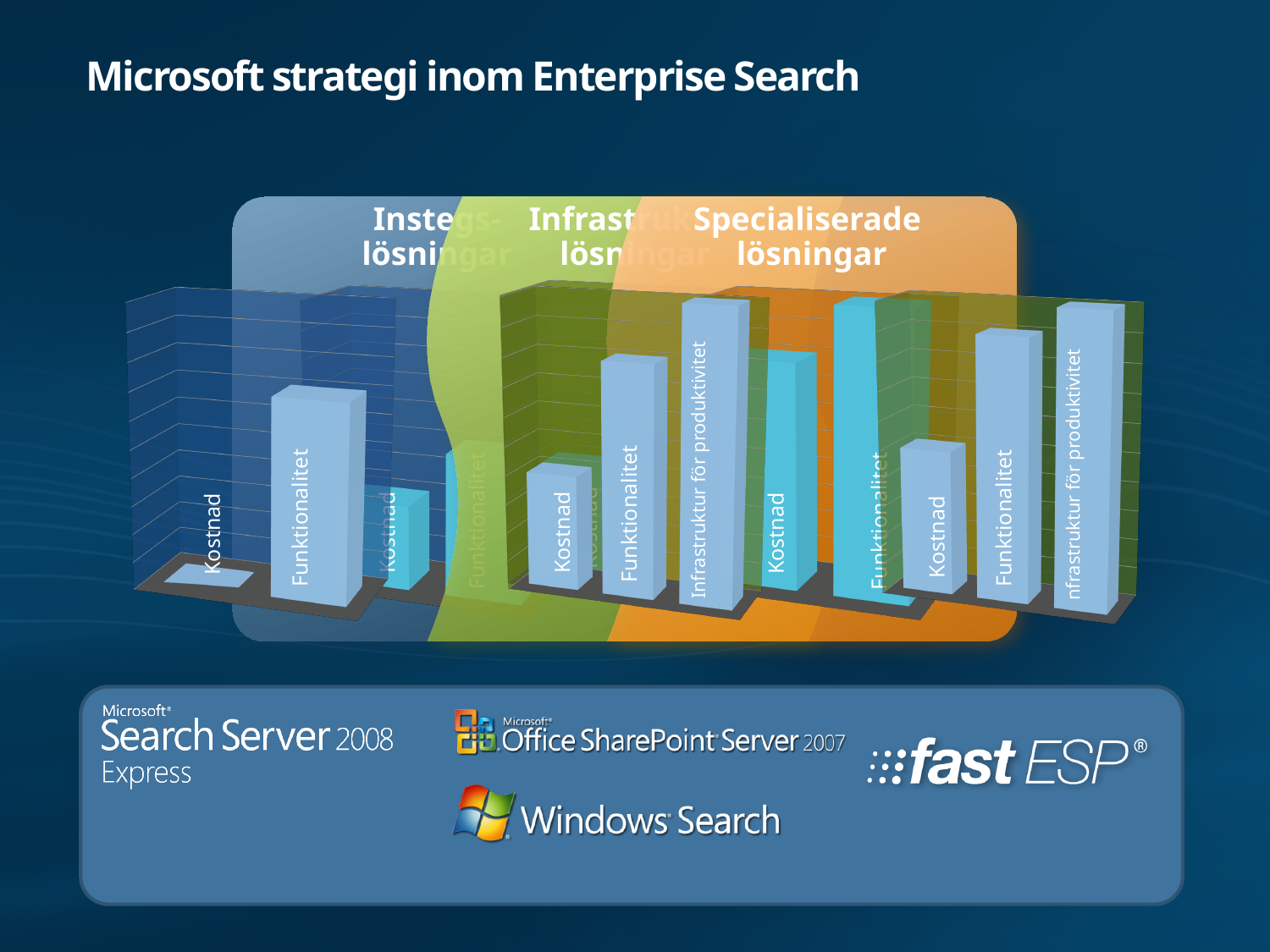
In the Specialiserade lösningar group, which bar is the tallest? Infrastruktur för produktivitet In the Instegs-lösningar group, which bar is the lowest? Kostnad In the Specialiserade lösningar group, which bar is the lowest? Kostnad In the Infrastruktur-lösningar group, which bar is taller: Kostnad or Infrastruktur för produktivitet? Infrastruktur för produktivitet How many solution groups (segments) does the chart divide the bars into? 3 In the Specialiserade lösningar group, which bar is taller: Kostnad or Infrastruktur för produktivitet? Infrastruktur för produktivitet Does the Kostnad bar rise or fall from the Instegs-lösningar group to the Infrastruktur-lösningar group? rise What kind of chart is shown on the slide? bar chart What are the names of the three solution groups labelled above the chart? Instegs-lösningar, Infrastruktur-lösningar, Specialiserade lösningar What is the title of the slide containing the chart? Microsoft strategi inom Enterprise Search In the Instegs-lösningar group, which bar is taller: Kostnad or Funktionalitet? Funktionalitet